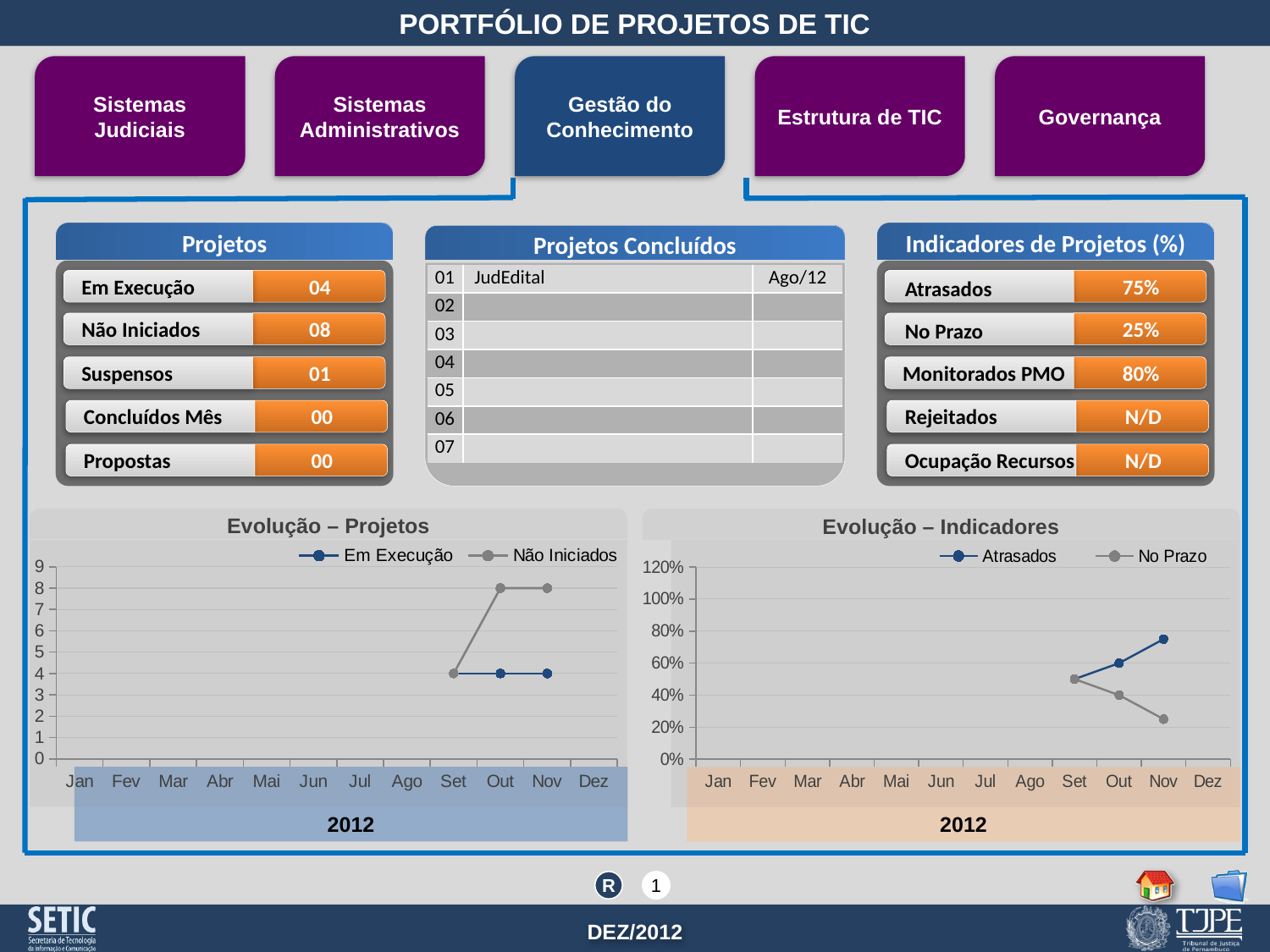
In the 'Evolução – Projetos' chart, what is the difference between Não Iniciados and Em Execução in Nov? 4 How many month categories are shown on the x axis of the 'Evolução – Projetos' chart? 12 In the 'Evolução – Projetos' chart, what is the value of Não Iniciados in Out? 8 In the 'Evolução – Indicadores' chart, does the No Prazo series rise or fall from Set to Nov? fall In the 'Evolução – Projetos' chart, what is the value of Em Execução in Nov? 4 What kind of chart is the 'Evolução – Projetos' chart? line chart How many series does the legend of the 'Evolução – Projetos' chart list? 2 In the 'Evolução – Projetos' chart, does the Não Iniciados series rise or fall from Set to Out? rise In the 'Evolução – Indicadores' chart, what is the value of Atrasados in Out? 60% In the 'Evolução – Indicadores' chart, which series is higher in Nov, Atrasados or No Prazo? Atrasados In the 'Evolução – Indicadores' chart, is the value of No Prazo in Nov greater or less than 40%? less What kind of chart is the 'Evolução – Indicadores' chart? line chart